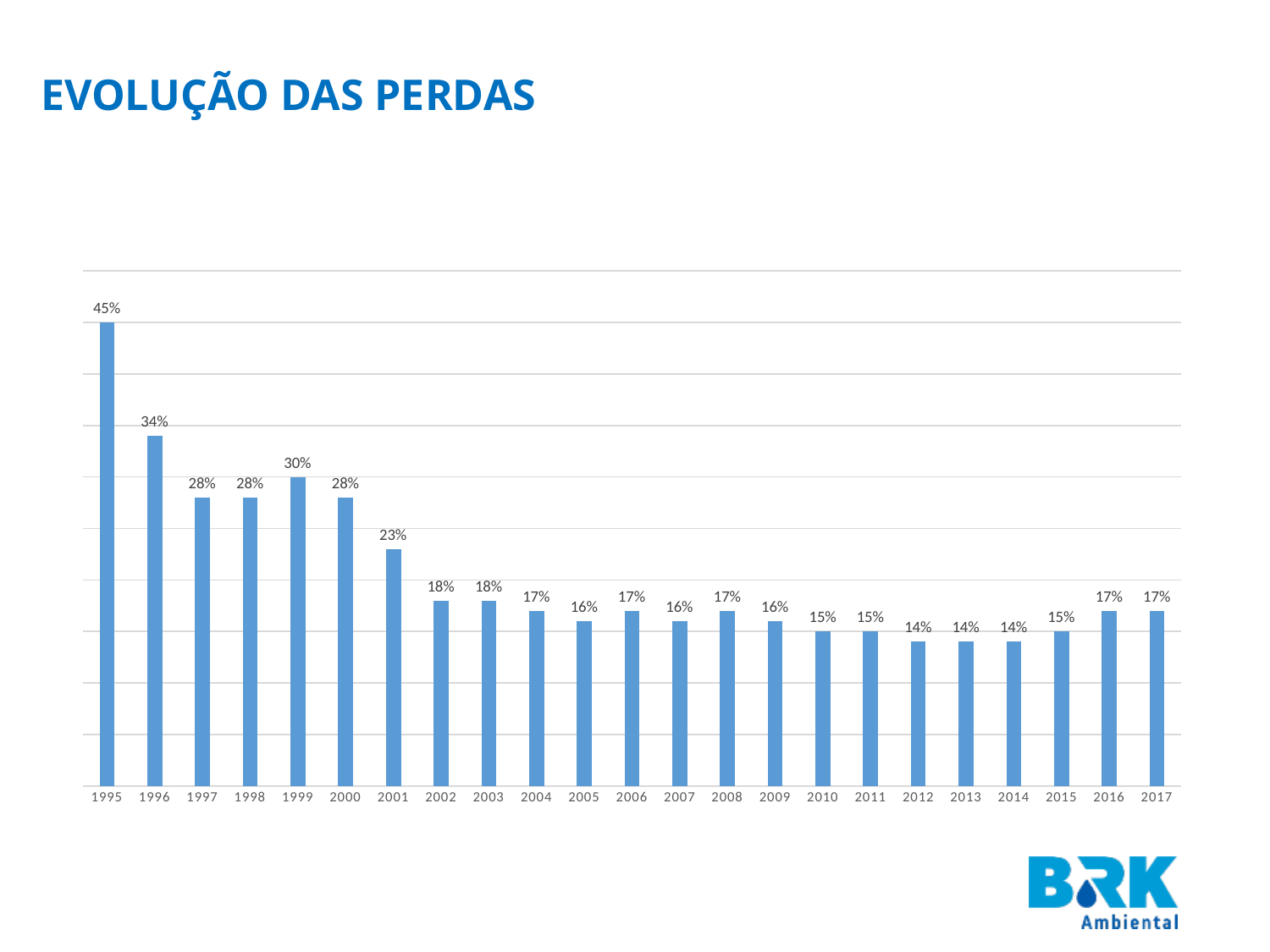
What is the lowest value shown on the chart? 14% Which is larger, the value for 1999 or the value for 2002? 1999 What is the title of the slide? EVOLUÇÃO DAS PERDAS What is the value for 2001? 23% What kind of chart is shown on the slide? Bar chart Which year has the highest value? 1995 What is the difference between the values for 1995 and 1996? 11% Do the values generally rise or fall from 1995 to 2017? Fall What is the value for 1995? 45% How many years are shown on the x axis? 23 What is the difference between the values for 2000 and 2001? 5% What is the value for 2017? 17%